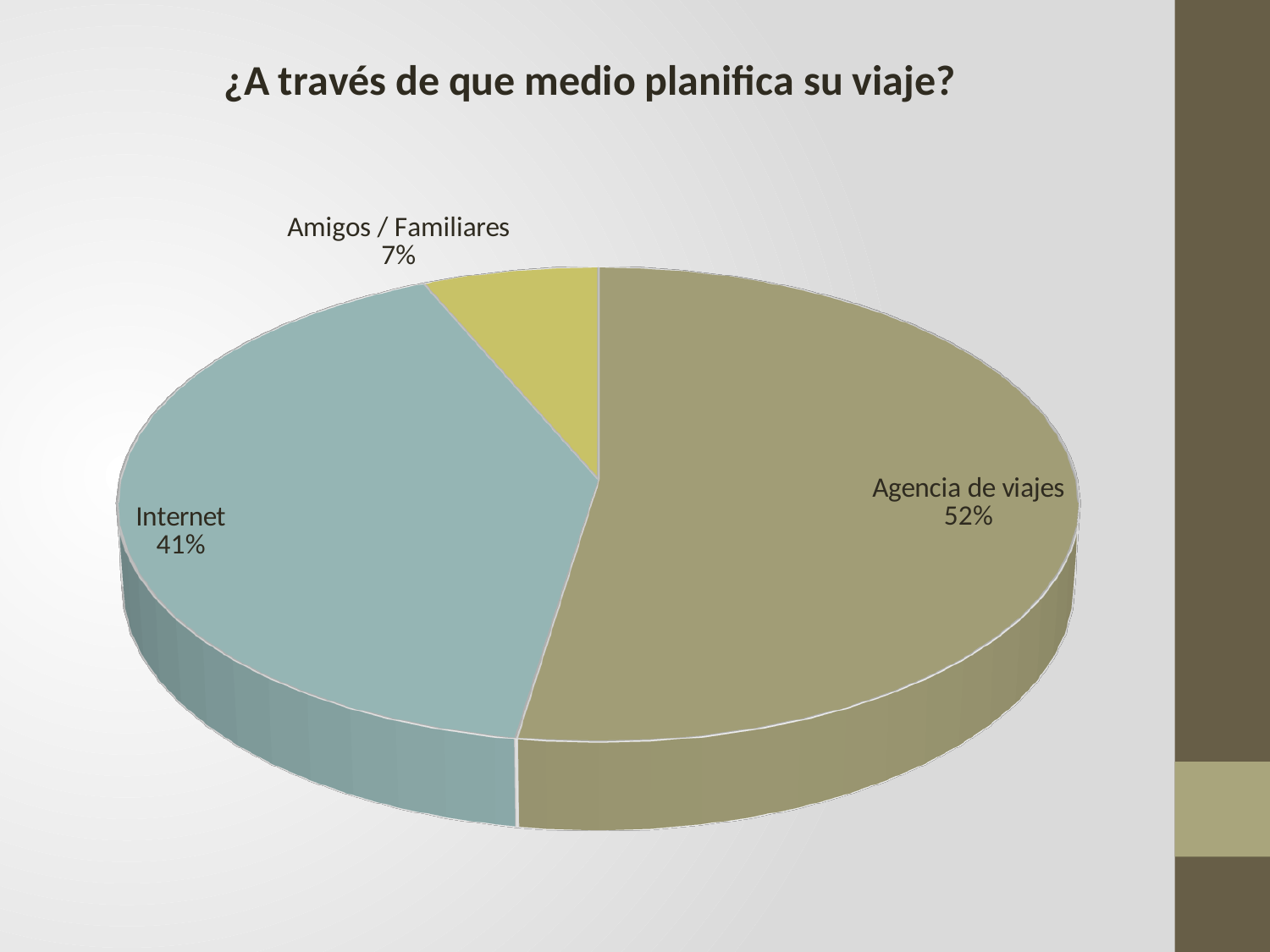
Which category has the largest slice of the pie? Agencia de viajes Which category has the smallest slice of the pie? Amigos / Familiares What is the difference in percentage points between Agencia de viajes and Internet? 11 What is the difference in percentage points between Internet and Amigos / Familiares? 34 What share of the pie does Internet represent? 41% What colour is the Internet slice? Blue-grey What share of the pie does Amigos / Familiares represent? 7% What share of the pie does Agencia de viajes represent? 52% What is the title of the chart? ¿A través de que medio planifica su viaje? What kind of chart is shown on the slide? Pie chart How many categories are shown in the pie chart? 3 Which is larger, the share for Internet or the share for Amigos / Familiares? Internet